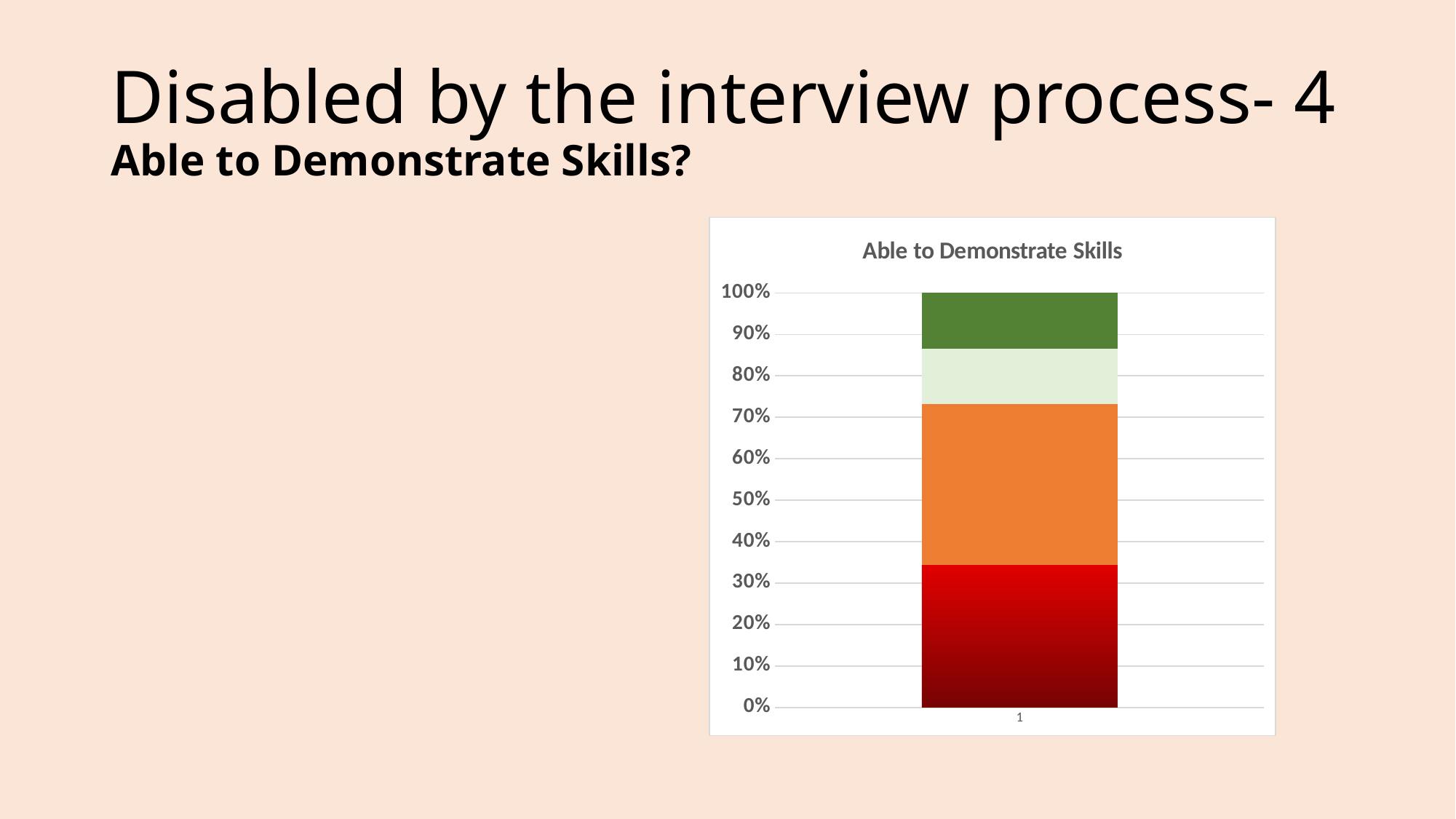
How many coloured segments make up the stacked bar? 4 How many bars does the chart contain? 1 What is the category label shown on the x axis? 1 What kind of chart is shown on the slide? Stacked bar chart Is the top of the light green segment greater or less than 90%? less Which is larger, the red segment or the orange segment? Orange What is the total height of the stacked bar? 100% Which coloured segment of the stacked bar is the largest? Orange Is the top of the red segment greater or less than 30%? greater What is the title of the chart? Able to Demonstrate Skills Is the top of the orange segment greater or less than 70%? greater Which is larger, the red segment or the dark green segment? Red